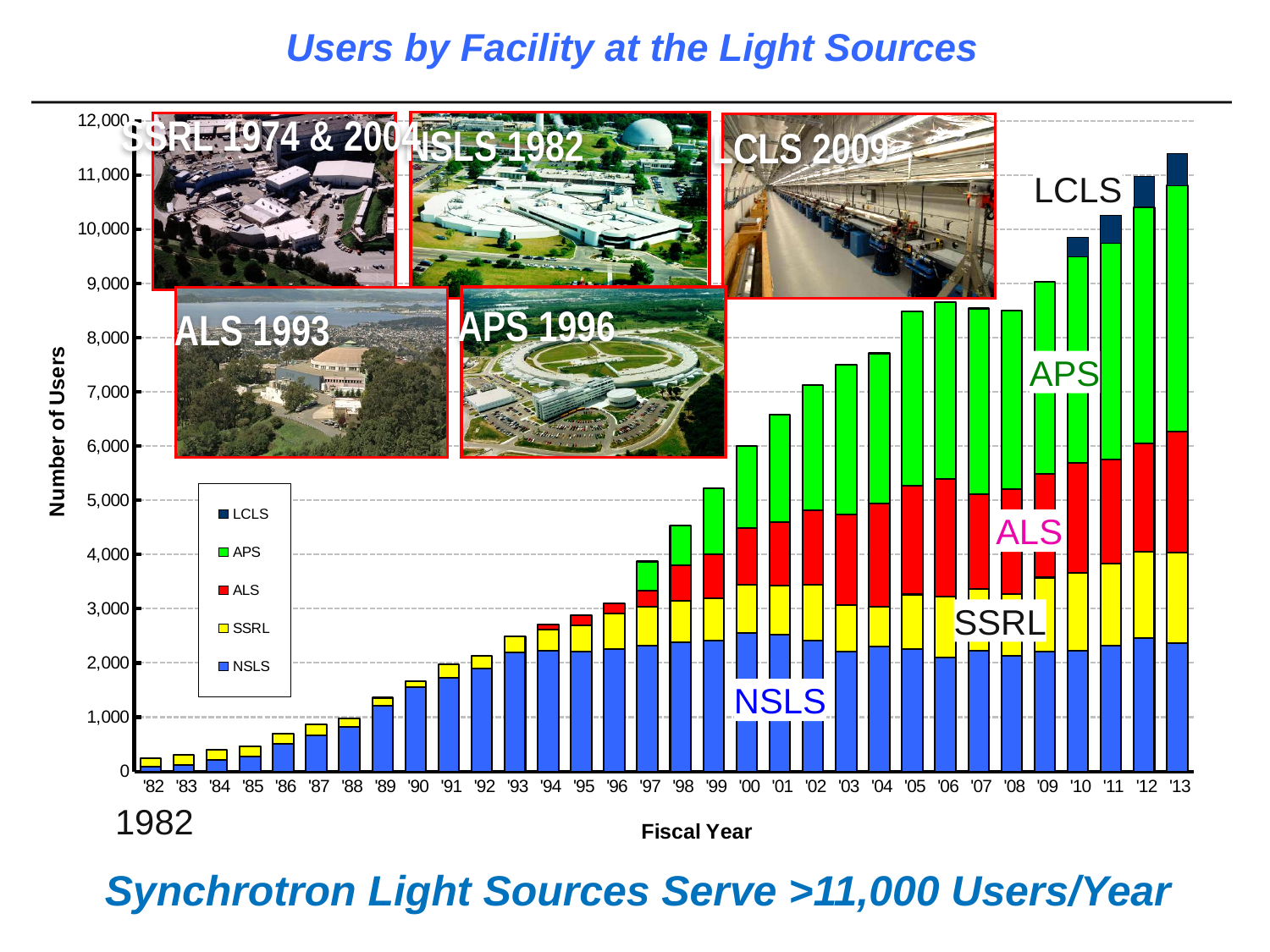
Is the total number of users in '13 greater or less than 11,000? greater Overall, do the total users rise or fall from '82 to '13? rise How many fiscal years are plotted along the x axis? 32 Is the total number of users in '86 greater or less than 1,000? less Which series is shown in green in the legend? APS What kind of chart is shown on the slide? Stacked bar chart Is the total number of users in '10 greater or less than 10,000? less Which fiscal year has the shortest stacked bar? '82 How many series does the legend list? 5 Which fiscal year has the tallest stacked bar? '13